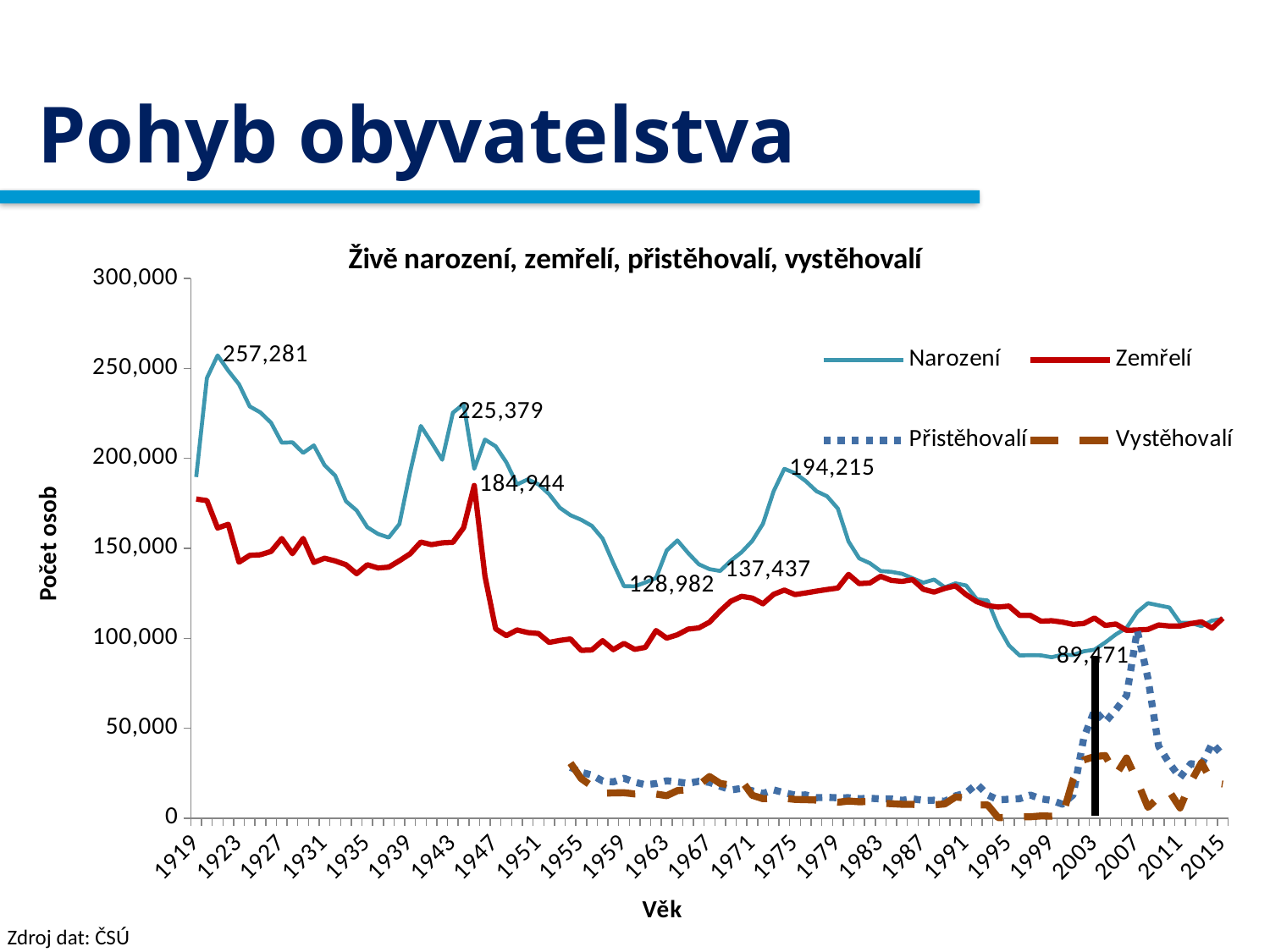
What is the lowest labelled value of the Narození series? 89,471 What kind of chart is shown on the slide? line chart How many series does the legend list? 4 Which is larger: the labelled Narození value 194,215 or the labelled Narození value 225,379? 225,379 What is the difference between the labelled Narození values 257,281 and 225,379? 31,902 What is the difference between the labelled Narození value 225,379 and the labelled Zemřelí value 184,944? 40,435 What is the highest labelled value of the Narození series? 257,281 What is the labelled value of the Narození series around 1974? 194,215 Is the value of the Zemřelí series in 1919 greater or less than 150,000? greater What is the title of the vertical axis? Počet osob Does the Narození series rise or fall between 1921 and 1935? fall What is the labelled peak value of the Zemřelí series around 1945? 184,944